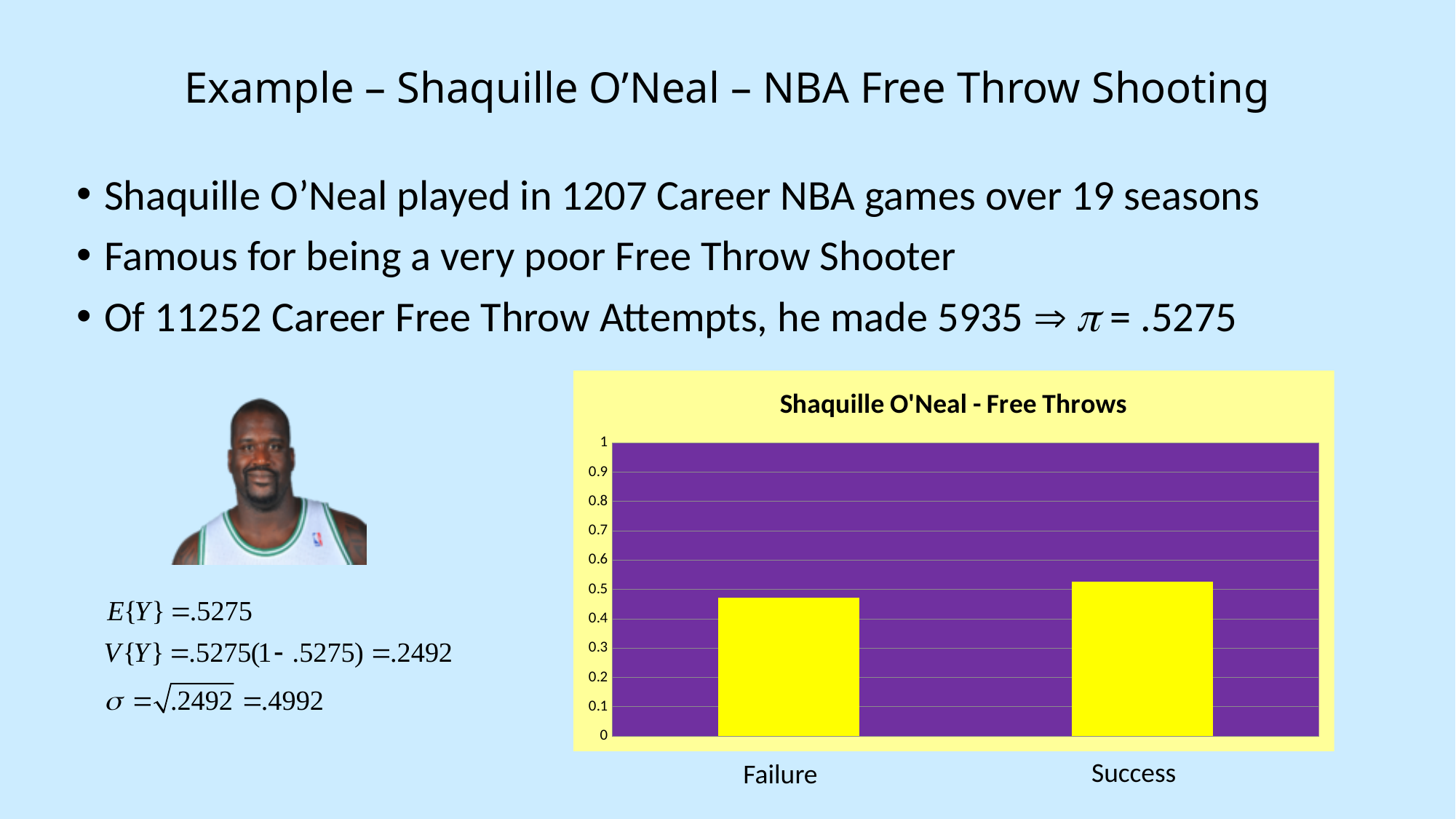
How many categories are shown on the x axis of the chart? 2 Is the value for Failure greater or less than 0.3? greater What is the maximum value shown on the y axis of the chart? 1 Is the value for Success greater or less than 0.4? greater What is the title of the chart? Shaquille O'Neal - Free Throws Which category has the lowest value in the chart? Failure Is the value for Success greater or less than 0.7? less Which category has the taller bar, Failure or Success? Success Do the values rise or fall from Failure to Success along the x axis? rise What kind of chart is shown on the slide? bar chart Which category has the highest value in the chart? Success